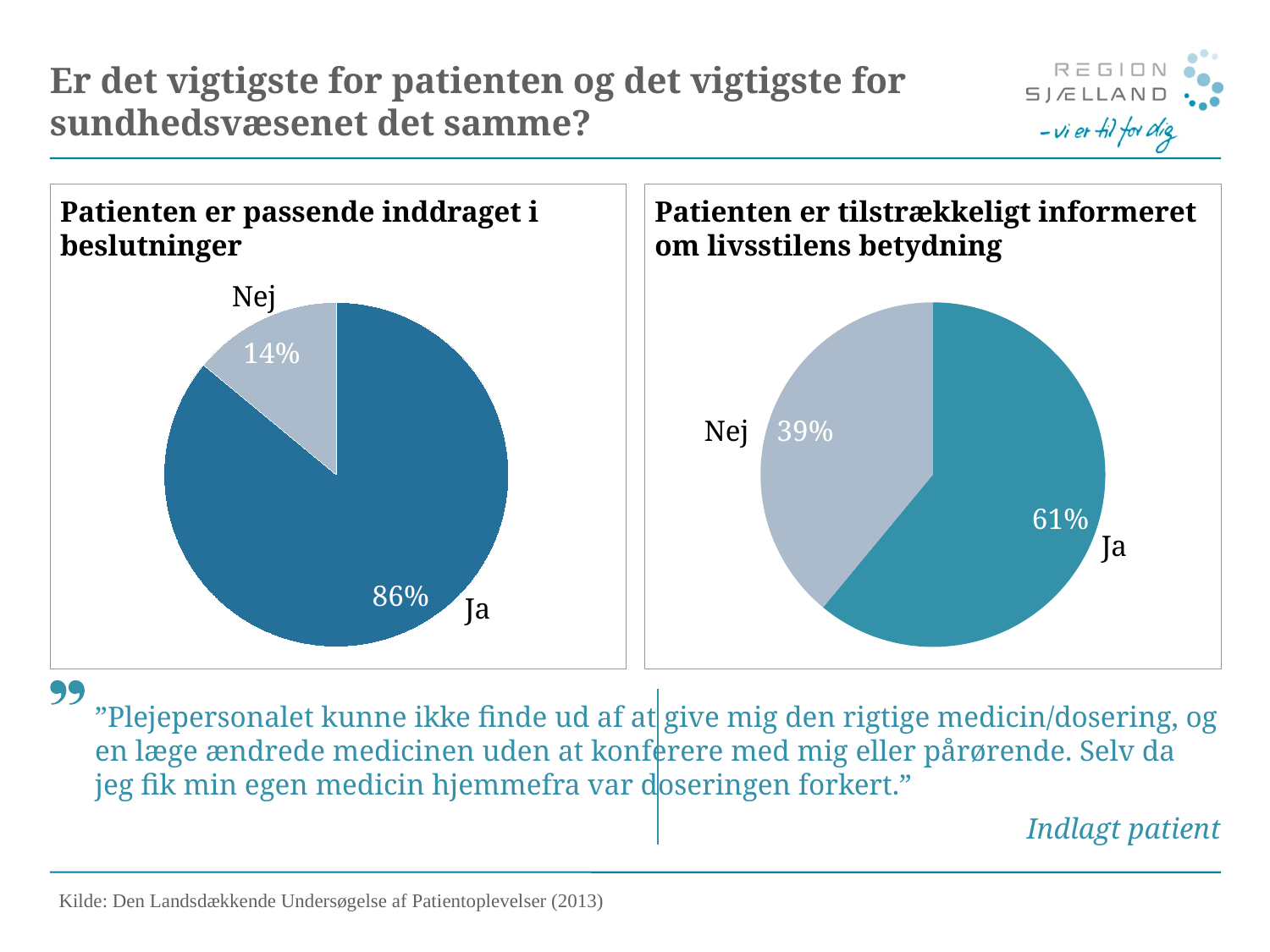
In the left chart, which answer has the largest share? Ja In the right chart 'Patienten er tilstrækkeligt informeret om livsstilens betydning', what percentage answered Ja? 61% In the left chart 'Patienten er passende inddraget i beslutninger', what percentage answered Ja? 86% How many slices does the right chart have? 2 In the left chart 'Patienten er passende inddraget i beslutninger', what percentage answered Nej? 14% What type of chart is used on the left side of the slide? Pie chart In the right chart, which answer has the smallest share? Nej In the right chart 'Patienten er tilstrækkeligt informeret om livsstilens betydning', what percentage answered Nej? 39% Is the Ja share larger in the left chart or in the right chart? Left chart In the left chart, what share of the pie does the Nej slice represent? 14% In the right chart, what is the difference in percentage points between Ja and Nej? 22 What is the title of the right chart? Patienten er tilstrækkeligt informeret om livsstilens betydning